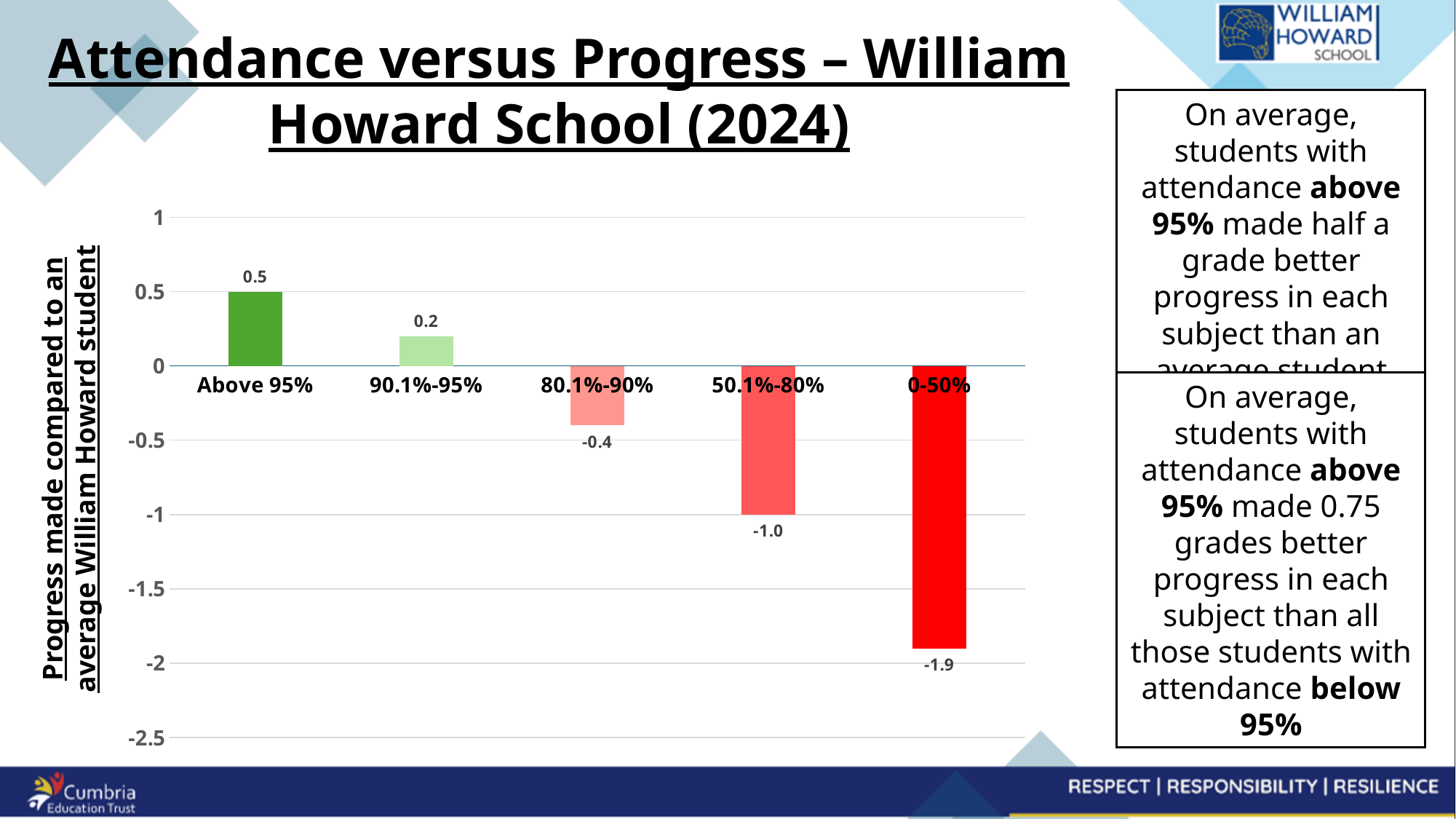
What is the progress value for the 0-50% attendance band? -1.9 Do the progress values rise or fall as attendance bands move from Above 95% to 0-50% along the x axis? Fall Which attendance band has the highest progress value? Above 95% Which has a larger progress value, the 90.1%-95% band or the 80.1%-90% band? 90.1%-95% How many attendance bands are shown on the chart? 5 What is the progress value for the 90.1%-95% attendance band? 0.2 What is the progress value for the 50.1%-80% attendance band? -1.0 Which attendance band has the lowest progress value? 0-50% What kind of chart is shown on the slide? Bar chart What is the difference between the progress values for Above 95% and 0-50% attendance? 2.4 What is the progress value for the 80.1%-90% attendance band? -0.4 What is the progress value for students with attendance Above 95%? 0.5